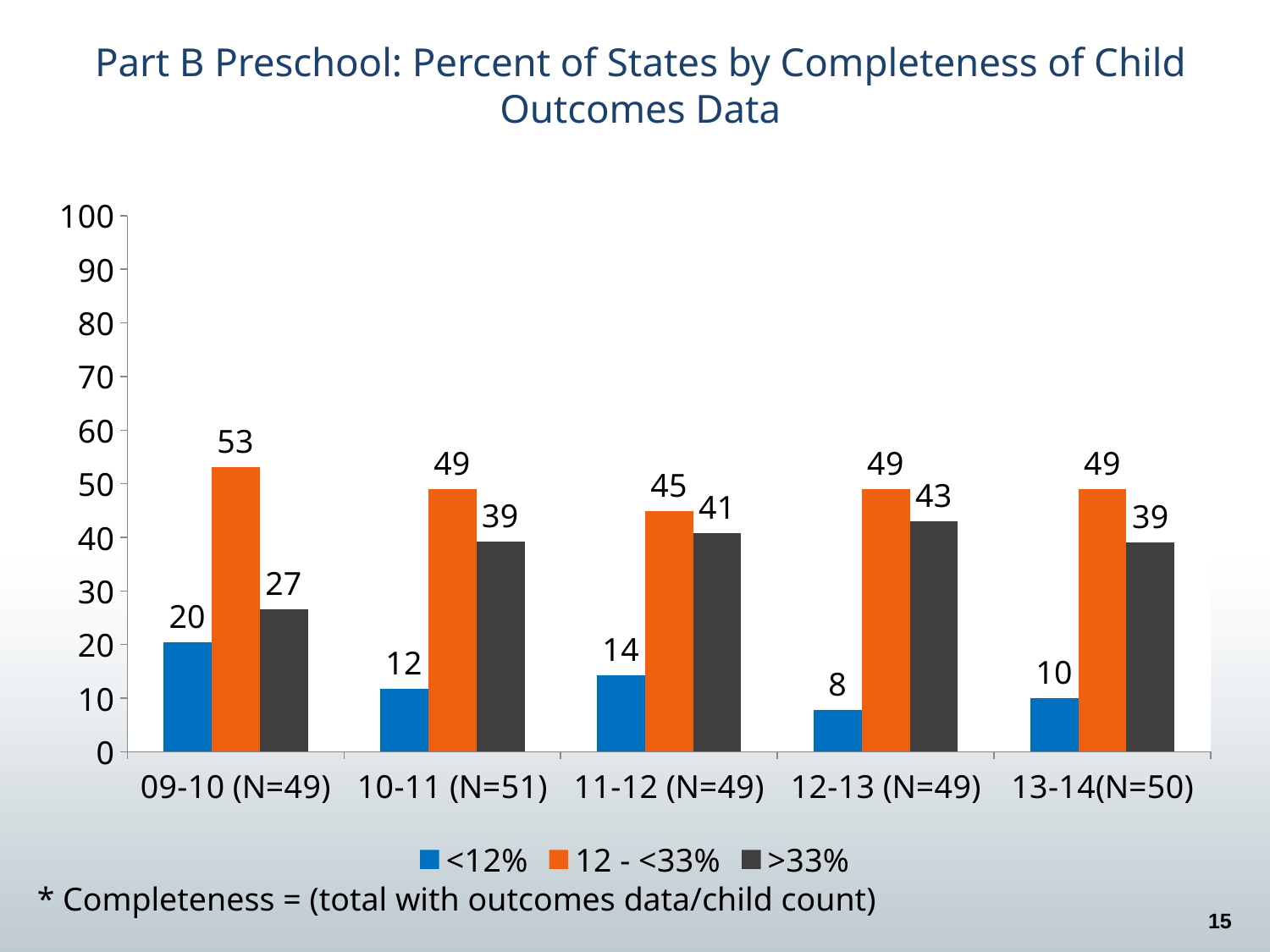
Is the value for the >33% series in 09-10 (N=49) greater or less than 30? less What is the value for the 12 - <33% series in 11-12 (N=49)? 45 Which year has the lowest value for the <12% series? 12-13 (N=49) What is the value for the >33% series in 12-13 (N=49)? 43 How many year categories are shown on the x axis? 5 What kind of chart is shown on the slide? bar chart How many series does the legend list? 3 What colour represents the >33% series? dark gray What is the difference between the >33% value in 12-13 (N=49) and in 09-10 (N=49)? 16 What is the value for the <12% series in 09-10 (N=49)? 20 Which year has the highest value for the 12 - <33% series? 09-10 (N=49) Which is larger in 10-11 (N=51): the 12 - <33% value or the >33% value? 12 - <33%